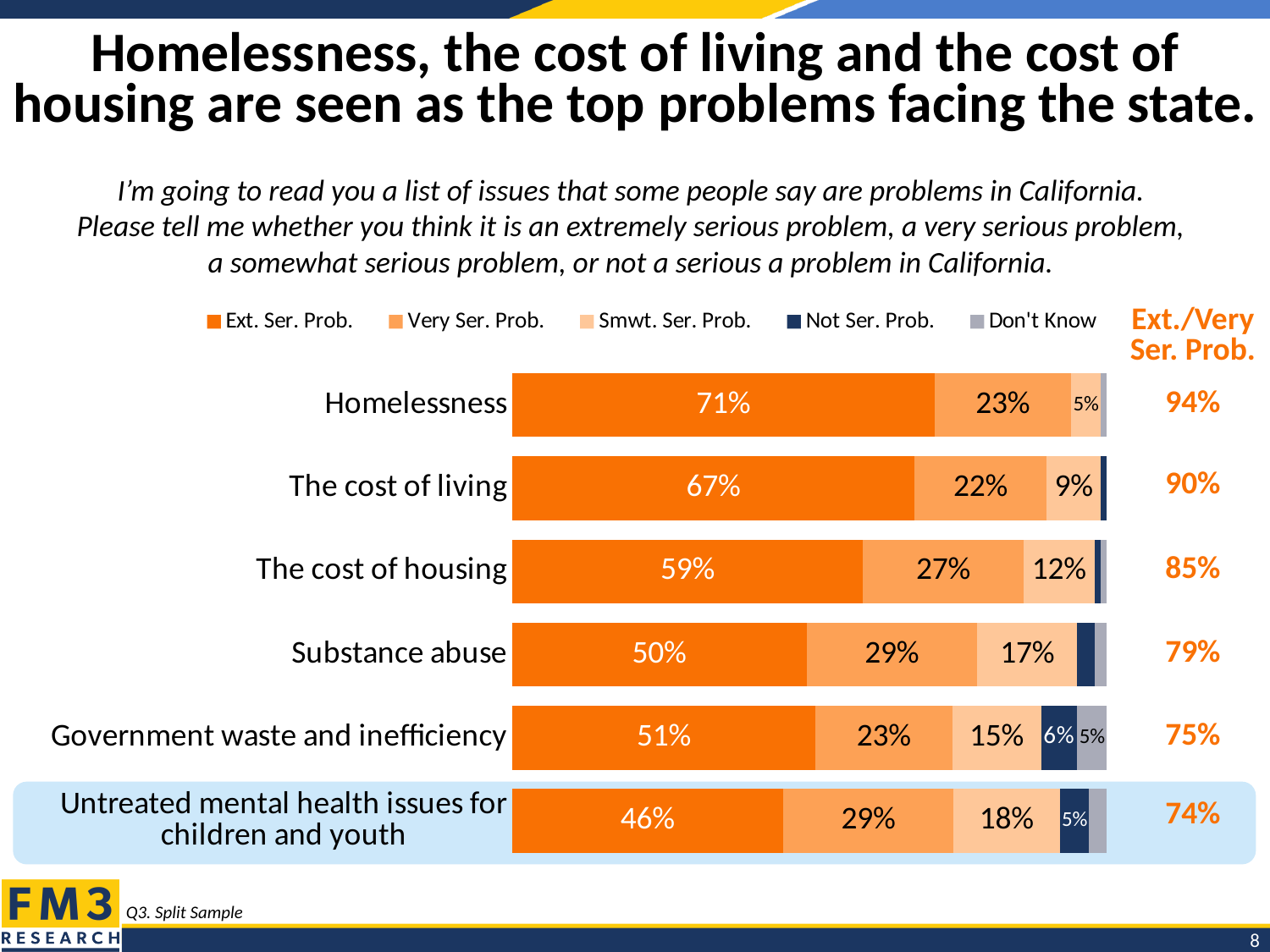
What is the difference between the 'Ext. Ser. Prob.' values for homelessness and the cost of living? 4% What is the combined Ext./Very Ser. Prob. figure shown for substance abuse? 79% What is the 'Smwt. Ser. Prob.' value for untreated mental health issues for children and youth? 18% Which issue has the lowest combined Ext./Very Ser. Prob. figure? Untreated mental health issues for children and youth How many issues are shown in the chart? 6 Which has a larger 'Ext. Ser. Prob.' value: substance abuse or government waste and inefficiency? Government waste and inefficiency What is the 'Very Ser. Prob.' value for the cost of housing? 27% What type of chart is shown on the slide? Stacked bar chart What is the 'Not Ser. Prob.' value for government waste and inefficiency? 6% Which issue has the highest 'Ext. Ser. Prob.' percentage? Homelessness How many response categories does the legend list? 5 What percentage of respondents said homelessness is an extremely serious problem? 71%